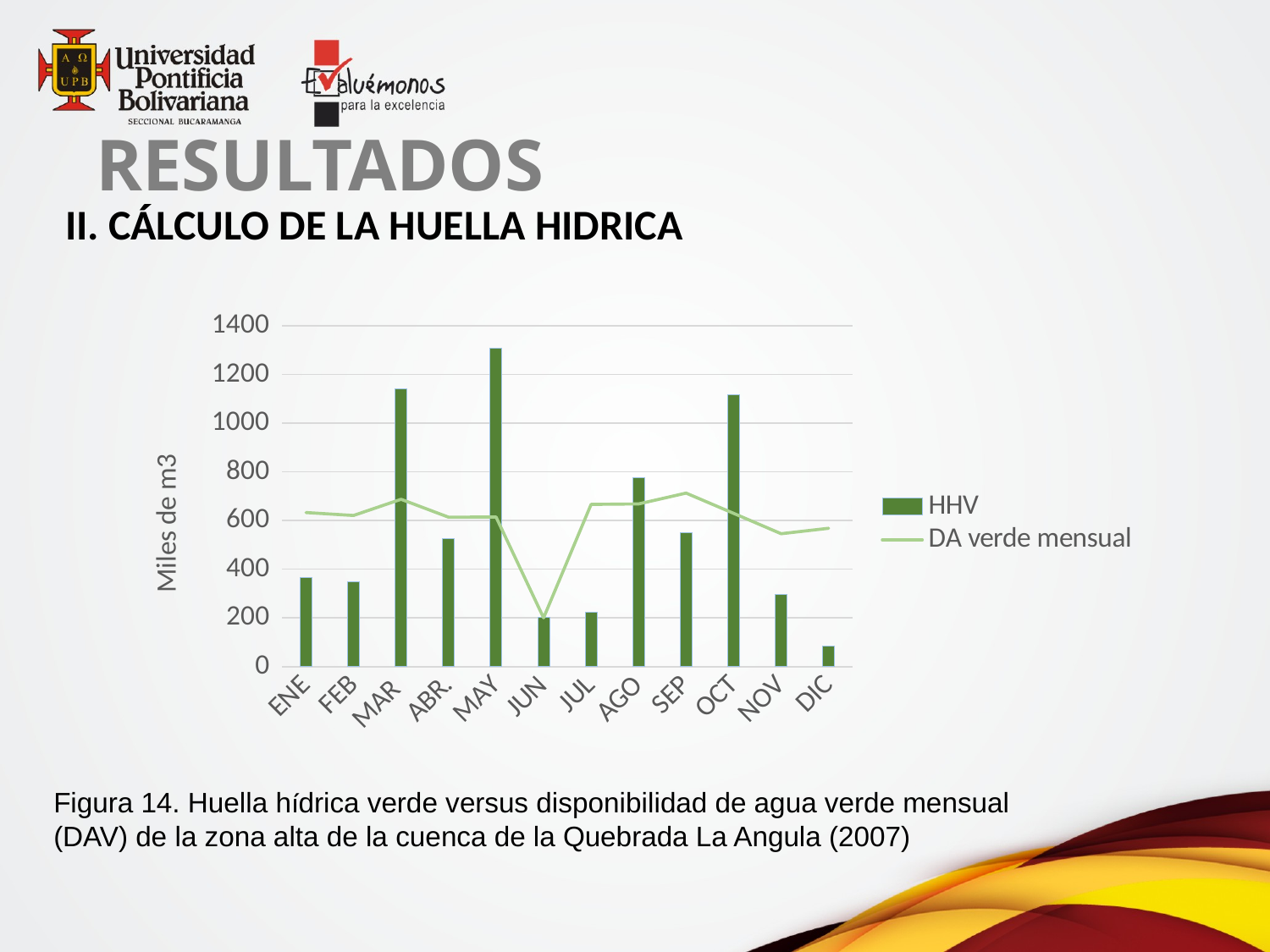
How many series does the legend list? 2 Is the DA verde mensual value for SEP greater or less than 600? greater Is the HHV value for DIC greater or less than 200? less Which is larger, the HHV bar for MAR or the HHV bar for AGO? MAR In MAY, which is larger, the HHV bar or the DA verde mensual line value? HHV Which month has the highest HHV bar? MAY In which month does the DA verde mensual line reach its lowest point? JUN How many months are shown on the x axis? 12 Which month has the lowest HHV bar? DIC Is the HHV value for MAR greater or less than 1000? greater